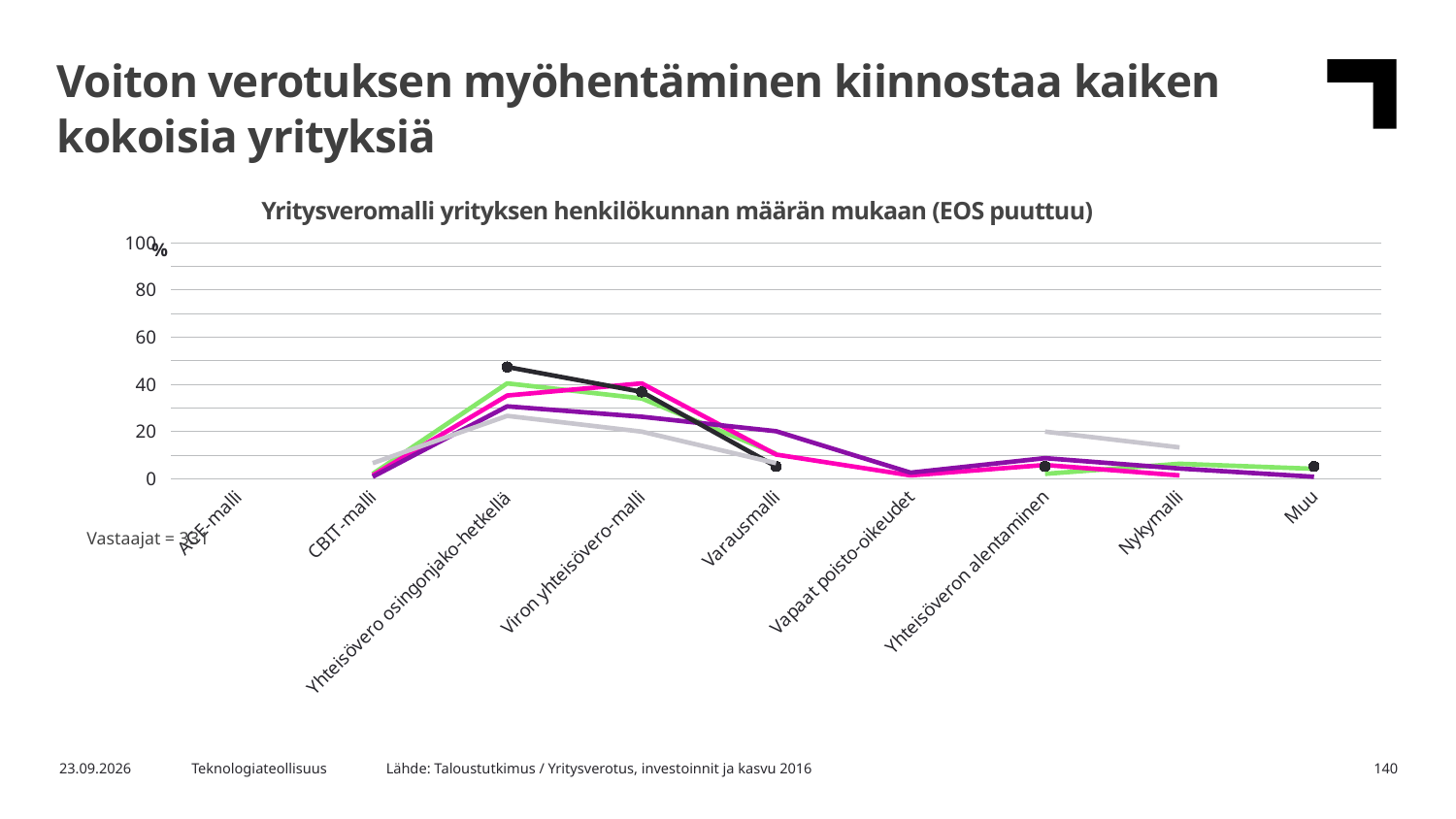
Is the value of the black line for Yhteisövero osingonjako-hetkellä greater or less than 40? greater What is the title of the chart? Yritysveromalli yrityksen henkilökunnan määrän mukaan (EOS puuttuu) Does any line in the chart reach a value greater than 60? No For the black line, which is larger: the value for Yhteisövero osingonjako-hetkellä or the value for Viron yhteisövero-malli? Yhteisövero osingonjako-hetkellä Is the value of the black line for Varausmalli greater or less than 20? less How many categories are shown on the x axis of the chart? 9 Does the black line rise or fall from Yhteisövero osingonjako-hetkellä to Varausmalli? fall For which category does the black line reach its highest value? Yhteisövero osingonjako-hetkellä What kind of chart is shown on the slide? line chart